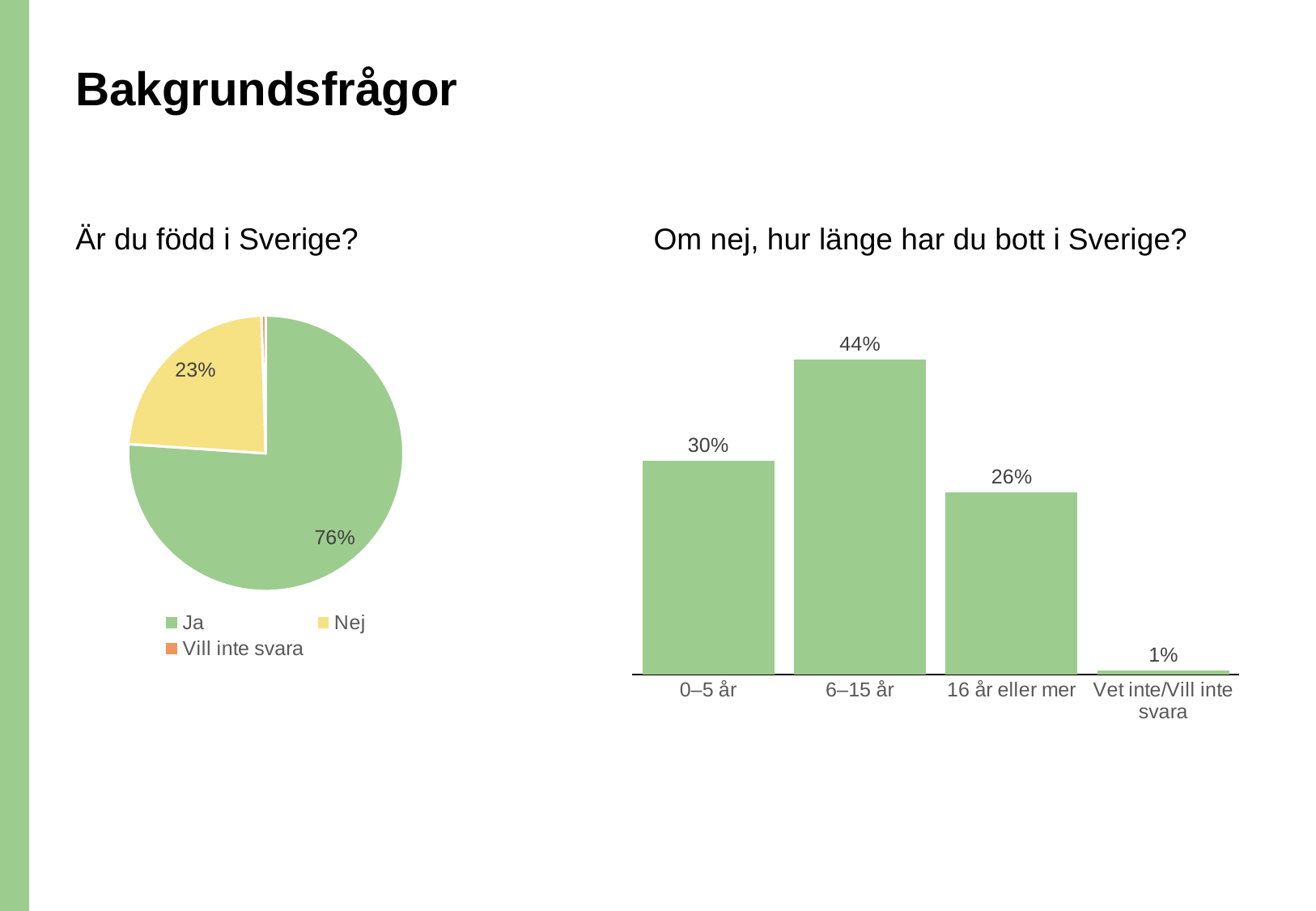
In the pie chart 'Är du född i Sverige?', what is the difference in percentage points between 'Ja' and 'Nej'? 53 percentage points In the bar chart 'Om nej, hur länge har du bott i Sverige?', what is the value for '16 år eller mer'? 26% In the bar chart 'Om nej, hur länge har du bott i Sverige?', what is the difference between '6–15 år' and '0–5 år'? 14 percentage points In the bar chart 'Om nej, hur länge har du bott i Sverige?', which category has the lowest value? Vet inte/Vill inte svara In the bar chart 'Om nej, hur länge har du bott i Sverige?', which is larger: '0–5 år' or '16 år eller mer'? 0–5 år In the pie chart 'Är du född i Sverige?', how many entries does the legend list? 3 In the pie chart 'Är du född i Sverige?', what share of respondents answered 'Nej'? 23% In the bar chart 'Om nej, hur länge har du bott i Sverige?', what is the value for '6–15 år'? 44% In the bar chart 'Om nej, hur länge har du bott i Sverige?', how many categories are shown? 4 In the pie chart 'Är du född i Sverige?', what share of respondents answered 'Ja'? 76% In the pie chart 'Är du född i Sverige?', which answer has the largest slice? Ja What kind of chart is used for 'Om nej, hur länge har du bott i Sverige?'? Bar chart